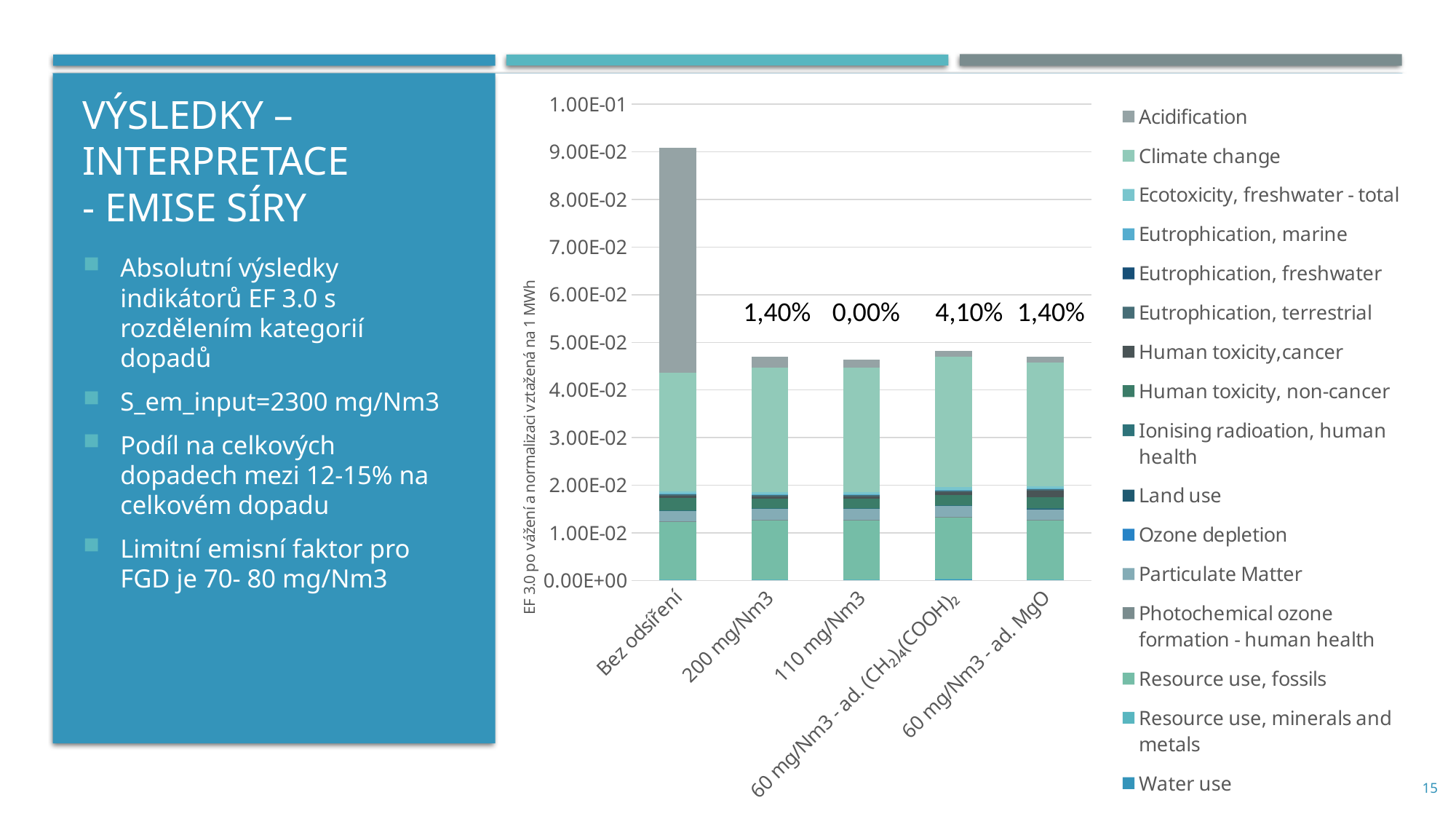
Is the total bar for 200 mg/Nm3 greater or less than 5.00E-02? less What percentage label is printed above the bar for 110 mg/Nm3? 0,00% How many categories are shown on the x axis of the chart? 5 Which has the larger total bar, Bez odsíření or 110 mg/Nm3? Bez odsíření Is the total bar for 60 mg/Nm3 - ad. MgO greater or less than 6.00E-02? less What kind of chart is shown on the slide? stacked bar chart Which category has the highest total bar in the chart? Bez odsíření How many series does the chart's legend list? 16 What percentage label is printed above the bar for 60 mg/Nm3 - ad. (CH₂)₄(COOH)₂? 4,10% Which category has the largest Acidification segment in the chart? Bez odsíření What is the label of the chart's vertical axis? EF 3.0 po vážení a normalizaci vztažená na 1 MWh Is the total bar for Bez odsíření greater or less than 8.00E-02? greater